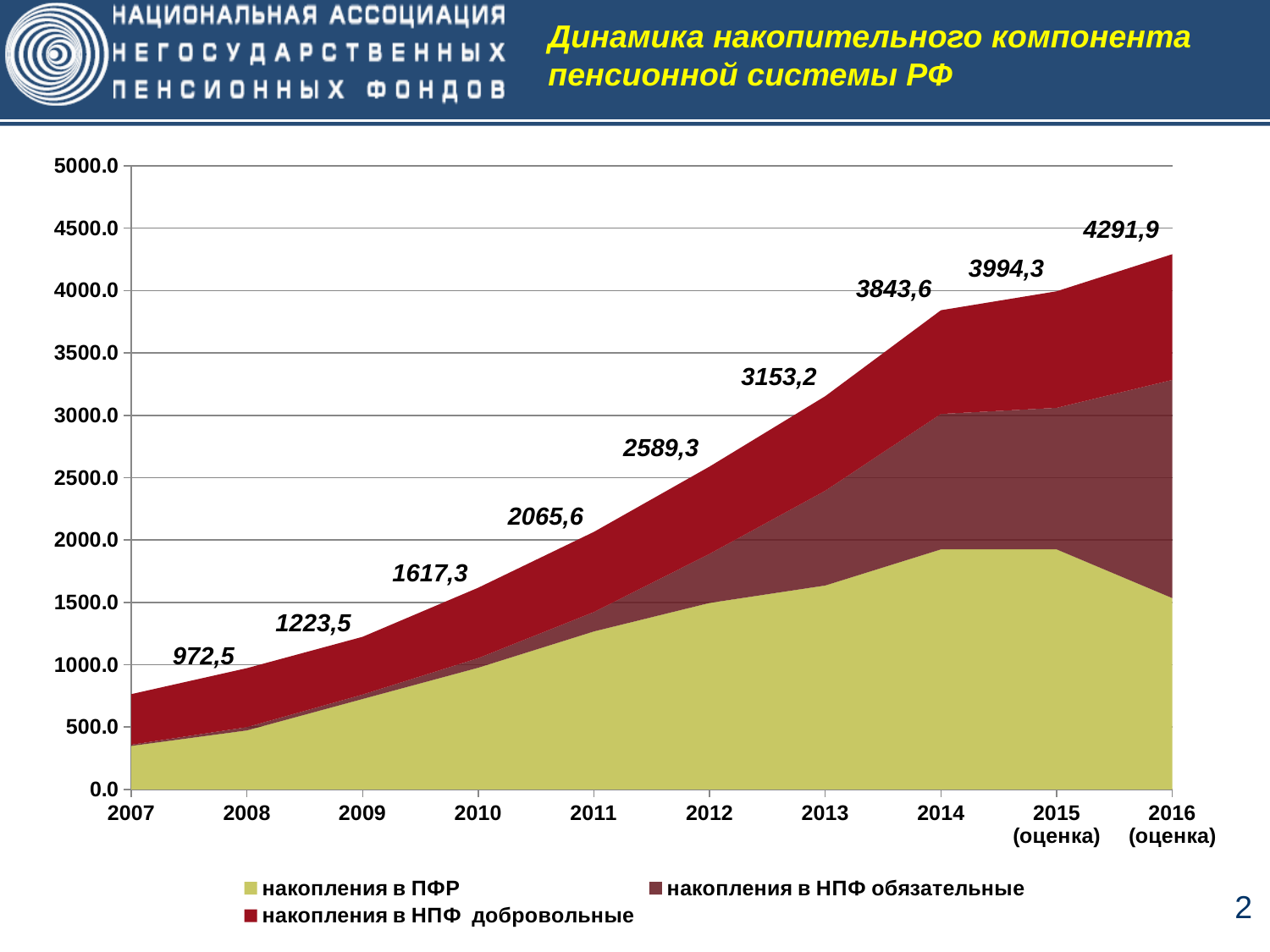
Which year has the lowest total value? 2007 What is the total value labelled for 2016 (оценка)? 4291,9 Which series is shown in yellow-green at the bottom of the chart? накопления в ПФР What is the total value labelled for 2015 (оценка)? 3994,3 How many series does the legend list? 3 What is the total value labelled for 2014? 3843,6 Do the total values rise or fall from 2007 to 2016? Rise What is the difference between the labelled totals for 2016 (оценка) and 2015 (оценка)? 297,6 Which year has the highest total value? 2016 (оценка) Is the total value for 2007 greater or less than 1000? less What type of chart is shown on the slide? Stacked area chart How many years are shown on the x axis? 10